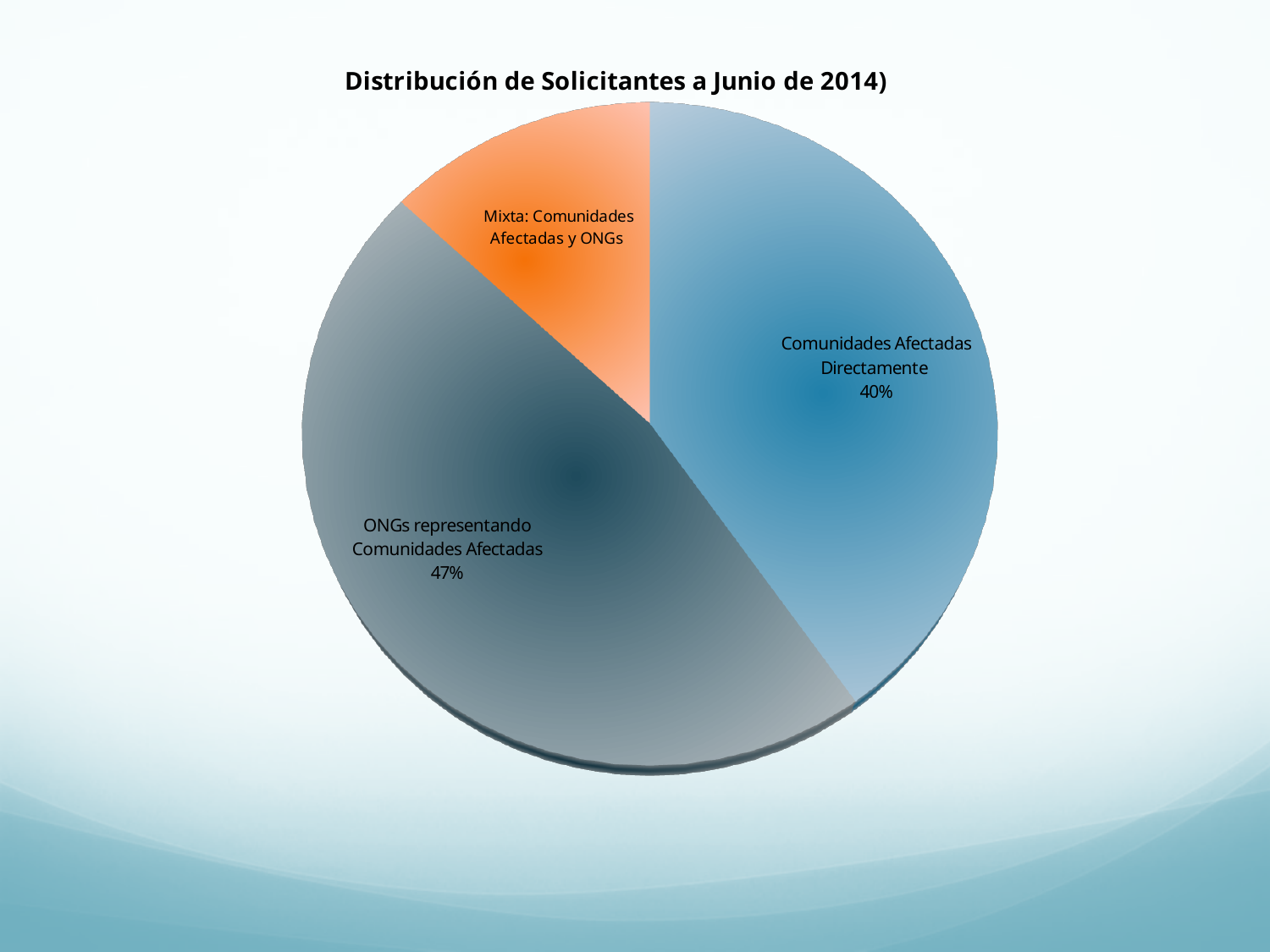
How many slices does the pie chart have? 3 Which is larger: the share for 'ONGs representando Comunidades Afectadas' or the share for 'Comunidades Afectadas Directamente'? ONGs representando Comunidades Afectadas What is the title of the chart? Distribución de Solicitantes a Junio de 2014) What share of the pie is labelled for 'ONGs representando Comunidades Afectadas'? 47% What share of the pie is labelled for 'Comunidades Afectadas Directamente'? 40% Which slice of the pie is the largest? ONGs representando Comunidades Afectadas What kind of chart is shown on the slide? Pie chart Which slice of the pie is the smallest? Mixta: Comunidades Afectadas y ONGs What colour is the 'Mixta: Comunidades Afectadas y ONGs' slice? Orange By how many percentage points does the 'ONGs representando Comunidades Afectadas' share exceed the 'Comunidades Afectadas Directamente' share? 7 percentage points